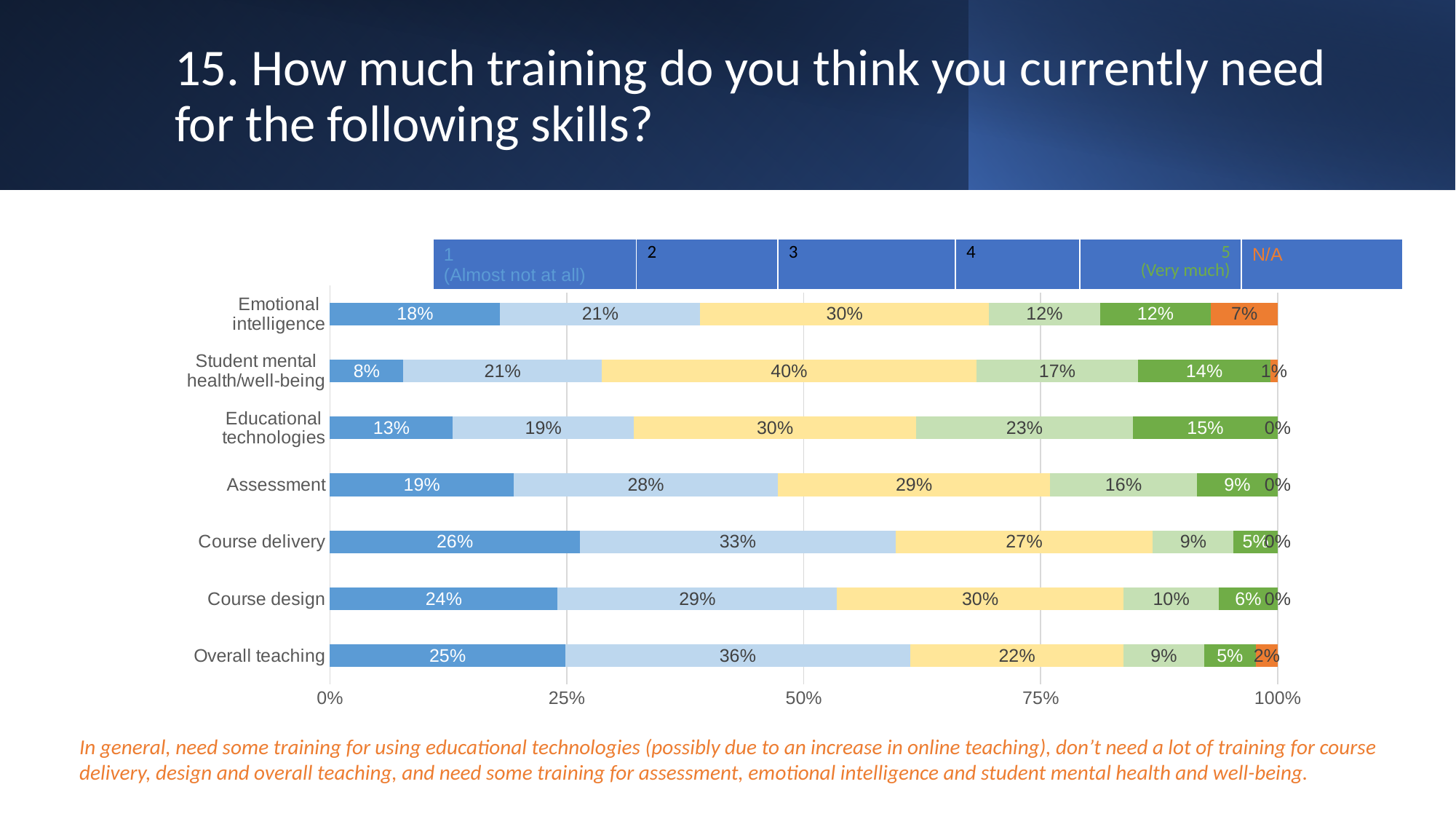
How many series does the legend list? 6 What is the value for 2 in the Course delivery bar? 33% What is the N/A share for Emotional intelligence? 7% How many skills are listed on the chart? 7 For Overall teaching, how much larger is the value for 2 than the value for 1? 11 percentage points What percentage of respondents chose 3 for Student mental health/well-being? 40% Which skill has the highest value for 5 (Very much)? Educational technologies Which is larger: the value for 4 in Educational technologies or the value for 4 in Emotional intelligence? Educational technologies Which skill has the lowest value for 1 (Almost not at all)? Student mental health/well-being What kind of chart is shown on the slide? Stacked bar chart What colour represents the N/A series in the chart? Orange Which skill has the highest value for 1 (Almost not at all)? Course delivery